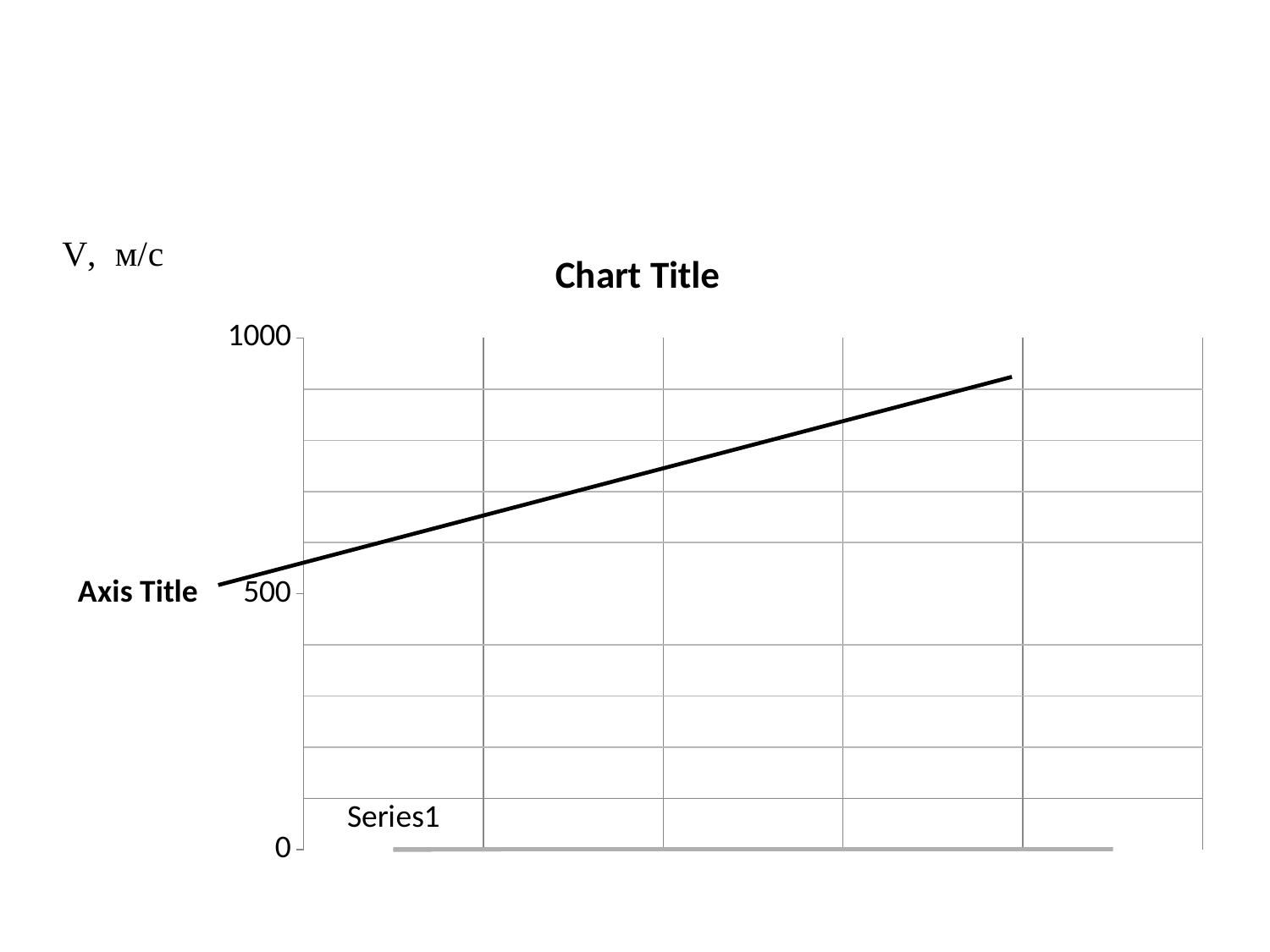
Is the value at the right end of the black line greater or less than 500? greater Does the black line rise or fall from left to right across the chart? rise What is the title of the chart? Chart Title What unit label is written at the top left of the chart? V, м/с What label is shown for the vertical axis title? Axis Title What is the highest value labelled on the vertical axis? 1000 What is the name of the series shown on the chart? Series1 What is the lowest value labelled on the vertical axis? 0